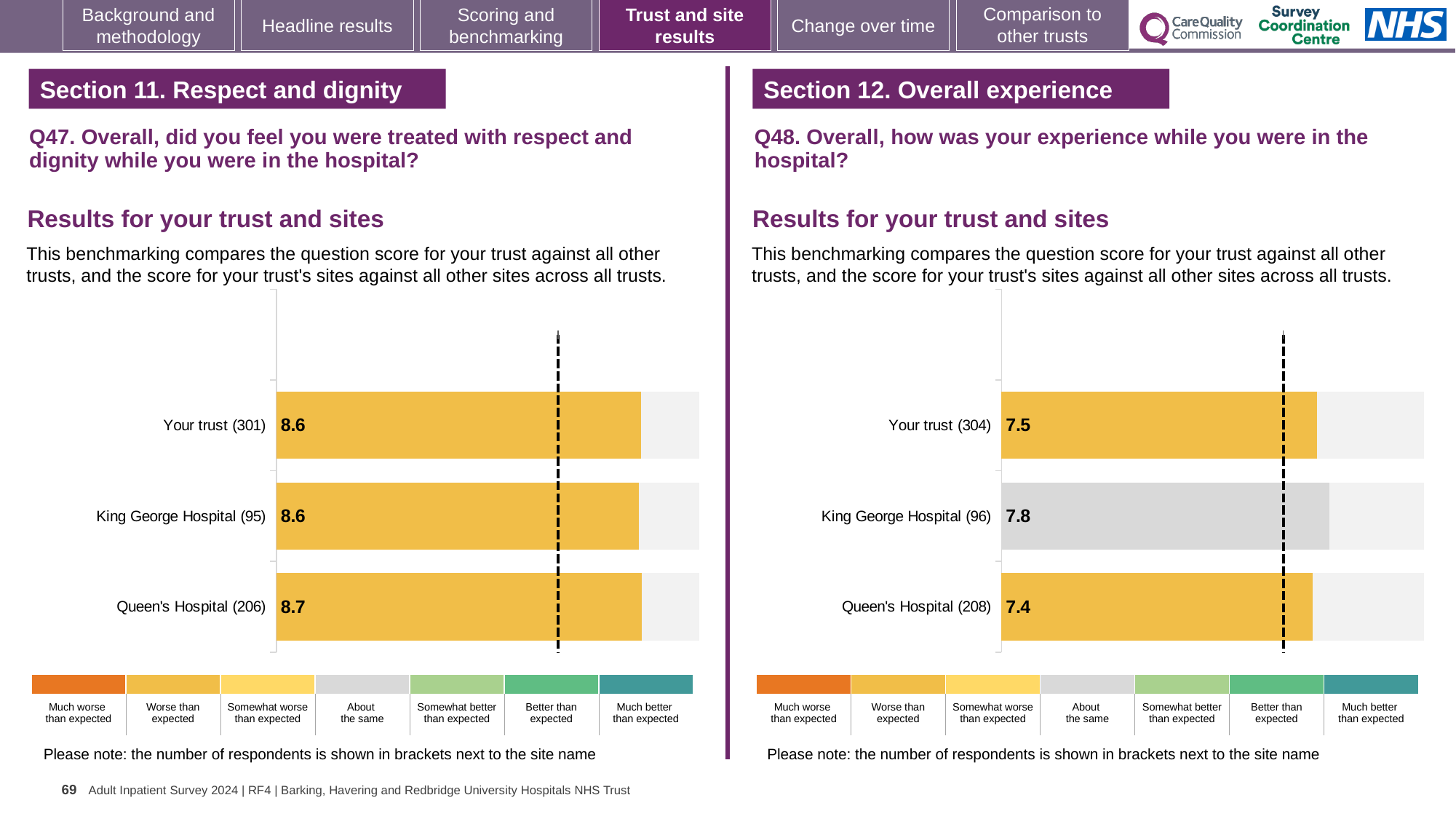
How many bars are plotted on the Q47 chart (Section 11)? 3 On the Q47 chart (Section 11), what is the difference between the Queen's Hospital score and the Your trust score? 0.1 On the Q48 chart (Section 12), how many respondents are shown in brackets for Queen's Hospital? 208 On the Q48 chart (Section 12), which site or trust row has the lowest score? Queen's Hospital On the Q48 chart (Section 12), which site or trust row has the highest score? King George Hospital On the Q48 chart (Section 12), what is the score for Your trust? 7.5 On the Q48 chart (Section 12), is the score for King George Hospital higher or lower than the score for Your trust? higher On the Q47 chart (Section 11, Respect and dignity), what is the score for Your trust? 8.6 On the Q48 chart (Section 12), what is the difference between the King George Hospital score and the Queen's Hospital score? 0.4 What type of chart is used on the Q48 chart (Section 12)? bar chart On the Q47 chart (Section 11), what is the score for Queen's Hospital? 8.7 On the Q48 chart (Section 12, Overall experience), what is the score for King George Hospital? 7.8